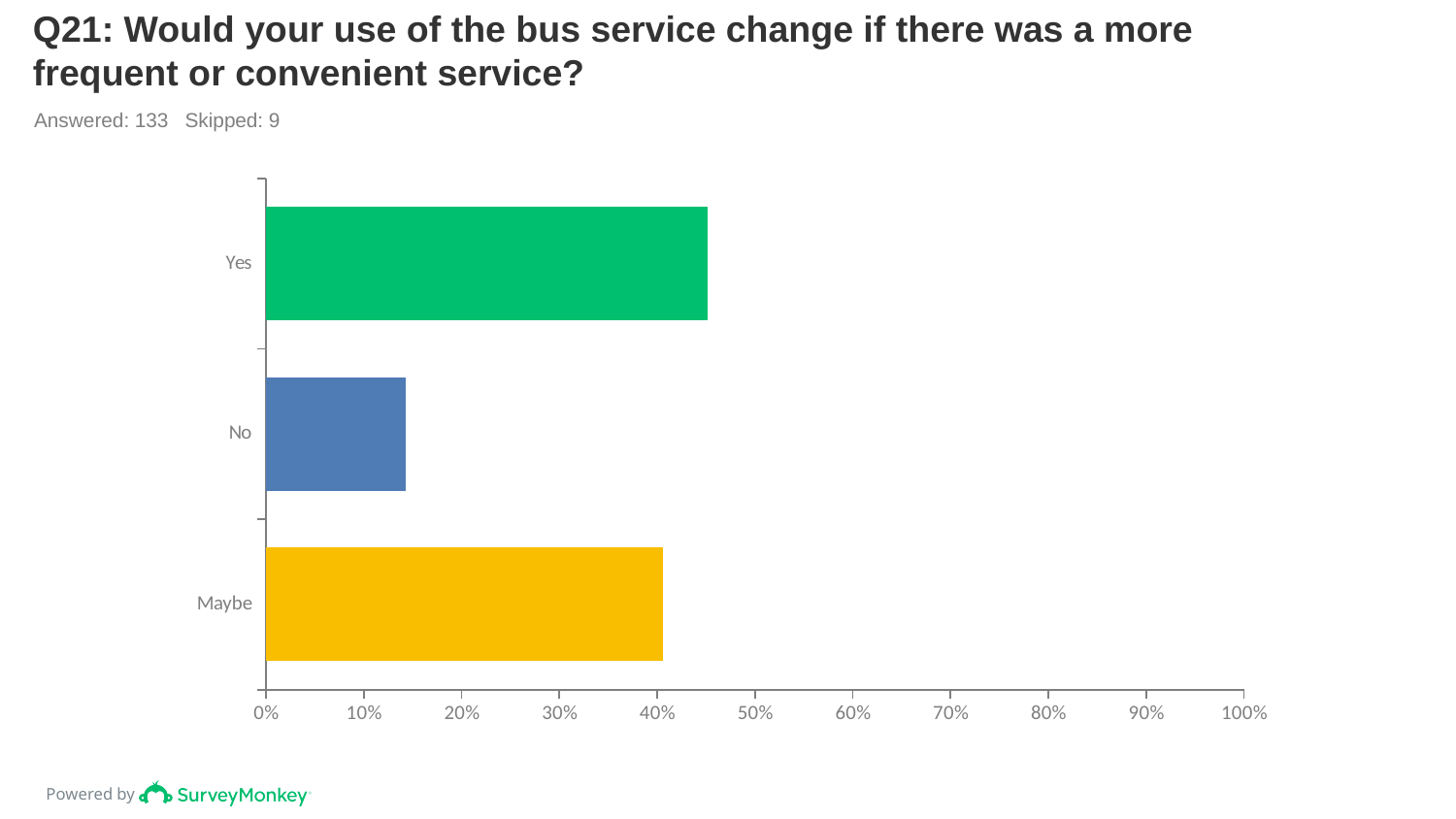
How many people answered this question according to the slide? 133 Is the value for Maybe greater or less than 30%? greater Is the value for No greater or less than 20%? less How many response categories are shown in the chart? 3 Is the value for No greater or less than 10%? greater What type of chart is shown on the slide? bar chart Which response category has the lowest value? No Which is larger, the value for Maybe or the value for No? Maybe Which response category has the highest value? Yes What colour is the bar for Maybe? yellow